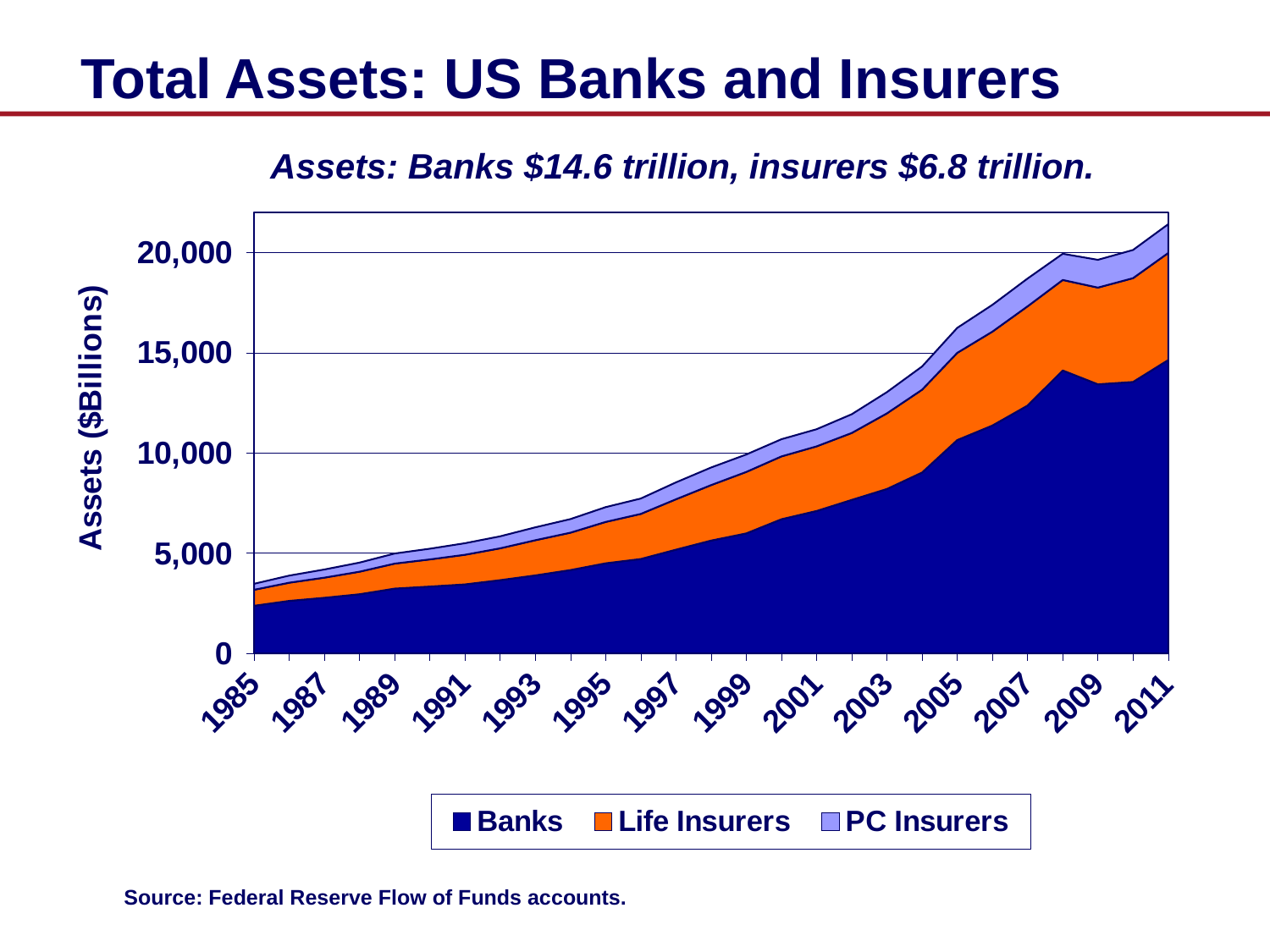
Which series has the largest assets in 2011: Banks or Life Insurers? Banks According to the subtitle, what are the total assets of US insurers? $6.8 trillion Is the combined total of all three series in 2011 greater or less than 20,000? greater What are the three series listed in the legend? Banks, Life Insurers, PC Insurers Do bank assets rise or fall from 1985 to 2011 overall? Rise Is the value for Banks in 1985 greater or less than 5,000? less According to the subtitle, what are the total assets of US banks? $14.6 trillion What kind of chart is shown on the slide? Stacked area chart Is the value for Banks in 1999 greater or less than 5,000? greater What is the title of the vertical axis? Assets ($Billions) How many series does the legend list? 3 Which series has larger assets in 2011: Life Insurers or PC Insurers? Life Insurers